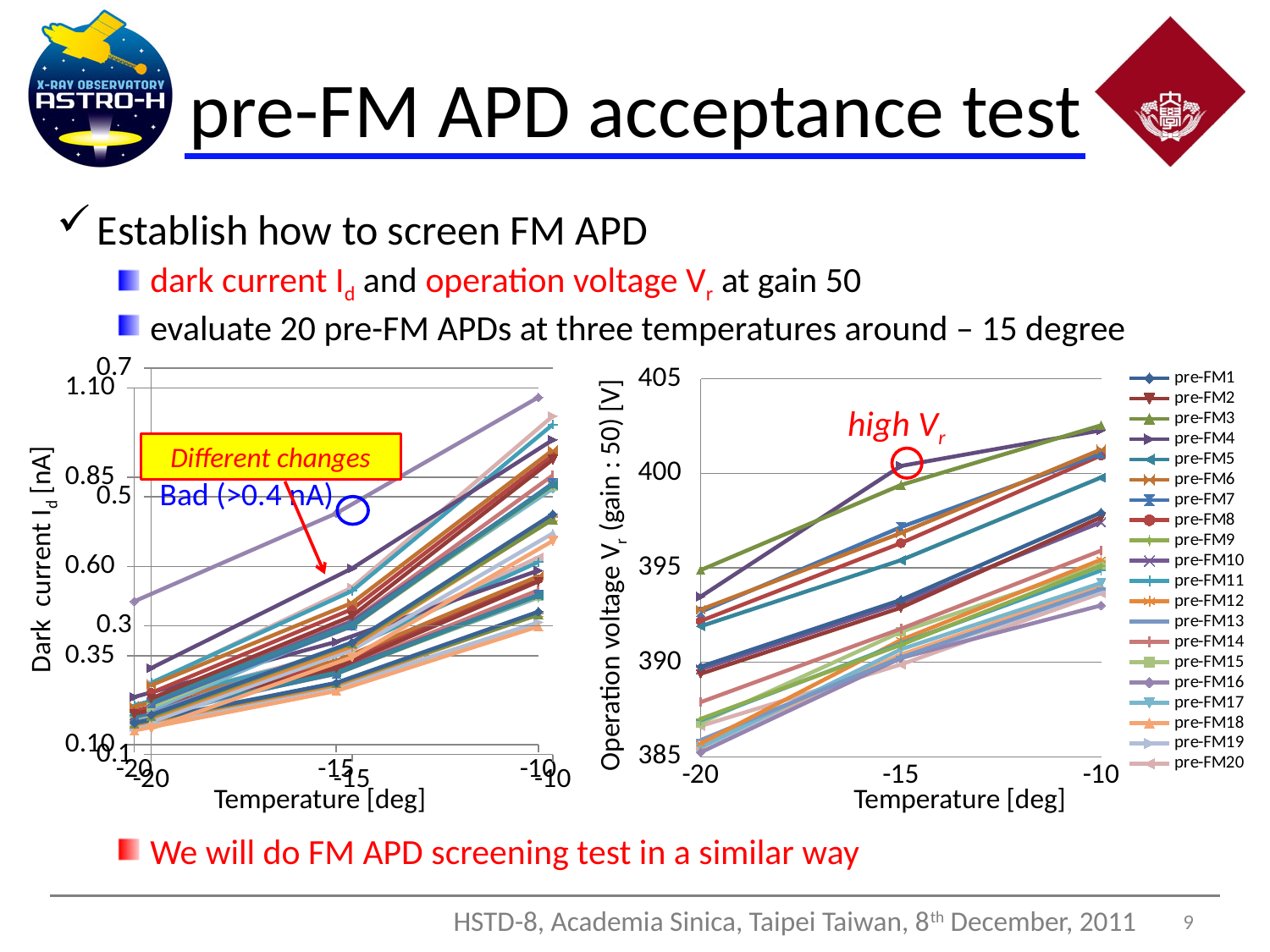
In the right chart, does the operation voltage rise or fall as temperature goes from -20 to -10 degrees? rise How many temperature points are plotted along the x axis of the right chart? 3 In the right chart, is the lowest operation voltage at -20 degrees greater or less than 390? less In the right chart, is the highest operation voltage at -10 degrees greater or less than 400? greater What kind of chart is the right chart showing operation voltage versus temperature? line chart What is the x-axis label of the right chart? Temperature [deg] In the right chart, what is the lowest value shown on the y axis? 385 How many series does the legend of the right chart list? 20 In the left chart, does the dark current rise or fall as temperature goes from -20 to -10 degrees? rise What is the first series listed in the legend of the right chart? pre-FM1 What kind of chart is the left chart showing dark current versus temperature? line chart